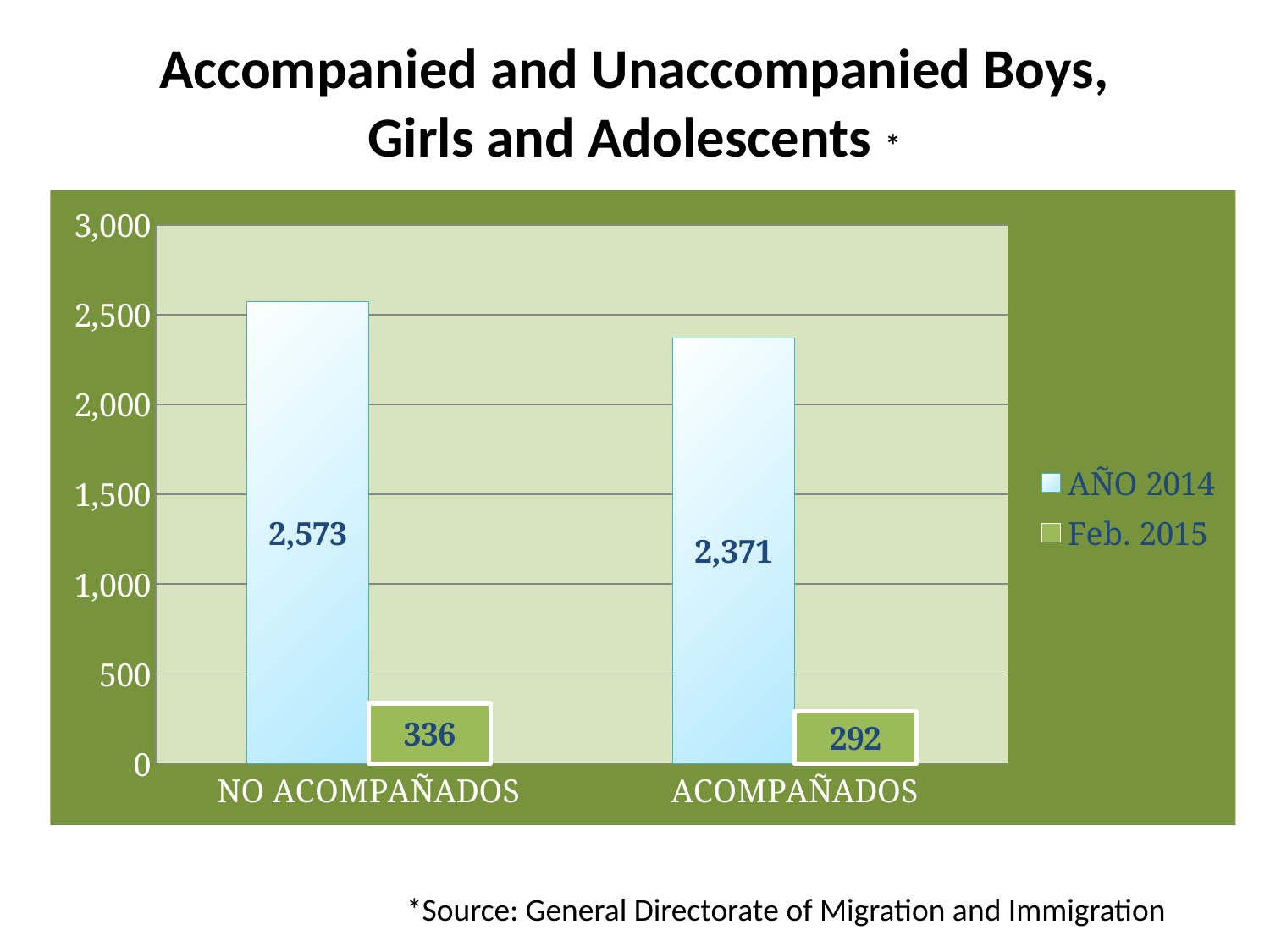
What is the Feb. 2015 value for NO ACOMPAÑADOS? 336 Which is larger: the Feb. 2015 value for NO ACOMPAÑADOS or for ACOMPAÑADOS? NO ACOMPAÑADOS What kind of chart is shown on the slide? bar chart What is the difference between the AÑO 2014 and Feb. 2015 values for ACOMPAÑADOS? 2,079 How many categories are shown on the x axis? 2 What is the difference between the AÑO 2014 values for NO ACOMPAÑADOS and ACOMPAÑADOS? 202 How many series does the legend list? 2 Which category has the highest AÑO 2014 value? NO ACOMPAÑADOS What is the AÑO 2014 value for NO ACOMPAÑADOS? 2,573 Is the AÑO 2014 value for ACOMPAÑADOS greater or less than 2,500? less Which category has the lowest Feb. 2015 value? ACOMPAÑADOS What is the Feb. 2015 value for ACOMPAÑADOS? 292